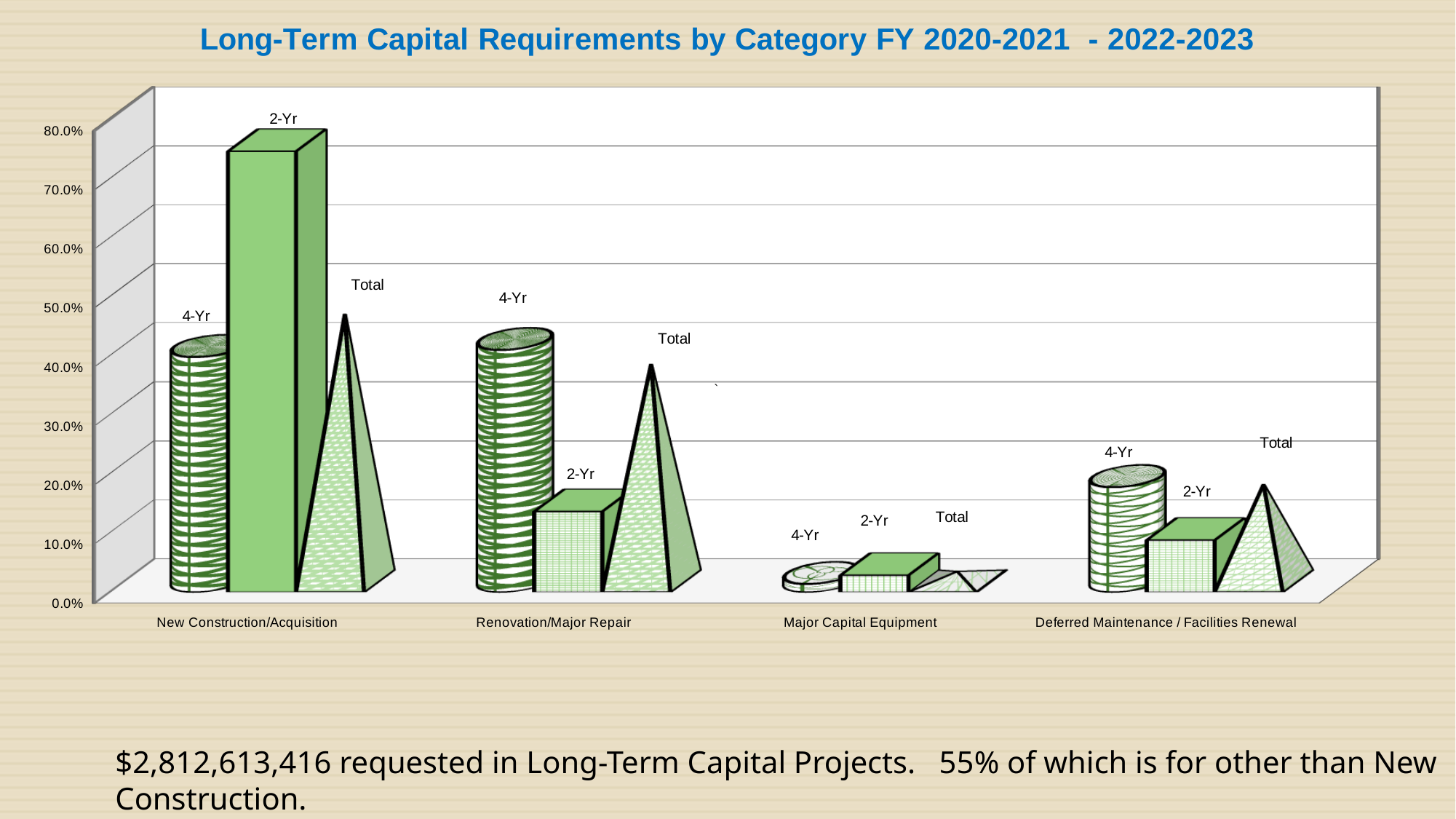
Which is larger for New Construction/Acquisition, the 2-Yr value or the 4-Yr value? 2-Yr What is the title of the chart? Long-Term Capital Requirements by Category FY 2020-2021 - 2022-2023 Is the 2-Yr value for New Construction/Acquisition greater or less than 70.0%? greater Which is larger for Renovation/Major Repair, the 4-Yr value or the 2-Yr value? 4-Yr Which category has the lowest 4-Yr value? Major Capital Equipment How many series are plotted for each category? 3 Which category has the highest 2-Yr value? New Construction/Acquisition Is the 4-Yr value for Major Capital Equipment greater or less than 10.0%? less What kind of chart is shown on the slide? bar chart How many categories are shown along the x axis? 4 Is the 2-Yr value for Renovation/Major Repair greater or less than 20.0%? less